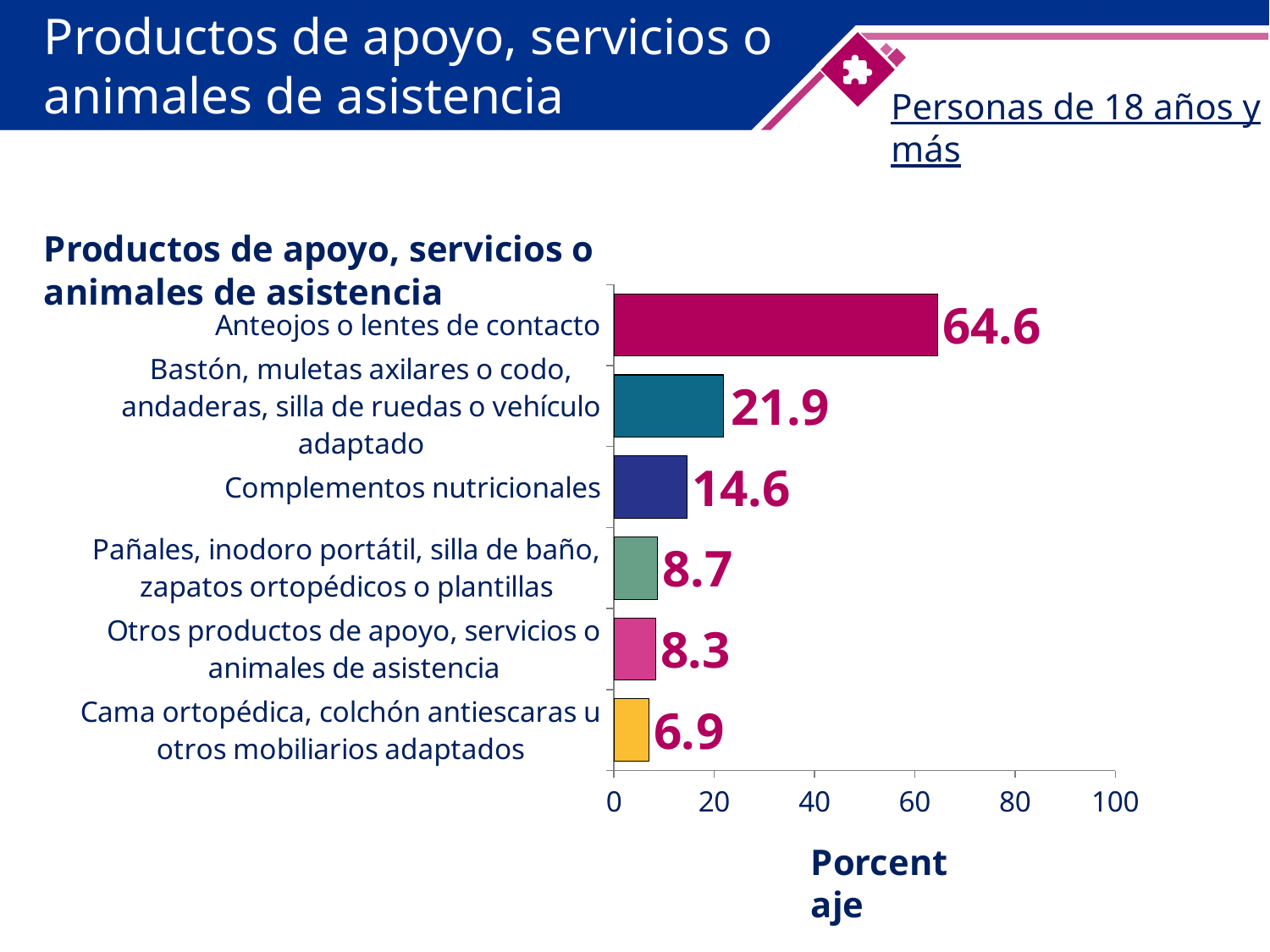
What is the label of the horizontal axis? Porcentaje Which category has the lowest value? Cama ortopédica, colchón antiescaras u otros mobiliarios adaptados Is the value for "Anteojos o lentes de contacto" greater or less than 60? greater Which category has the highest value? Anteojos o lentes de contacto What is the value for "Cama ortopédica, colchón antiescaras u otros mobiliarios adaptados"? 6.9 What is the value for "Anteojos o lentes de contacto"? 64.6 Which is larger: the value for "Pañales, inodoro portátil, silla de baño, zapatos ortopédicos o plantillas" or for "Otros productos de apoyo, servicios o animales de asistencia"? Pañales, inodoro portátil, silla de baño, zapatos ortopédicos o plantillas What is the value for "Complementos nutricionales"? 14.6 How many categories are shown in the chart? 6 What is the value for "Bastón, muletas axilares o codo, andaderas, silla de ruedas o vehículo adaptado"? 21.9 What is the difference between the values for "Anteojos o lentes de contacto" and "Complementos nutricionales"? 50.0 What kind of chart is shown on the slide? bar chart